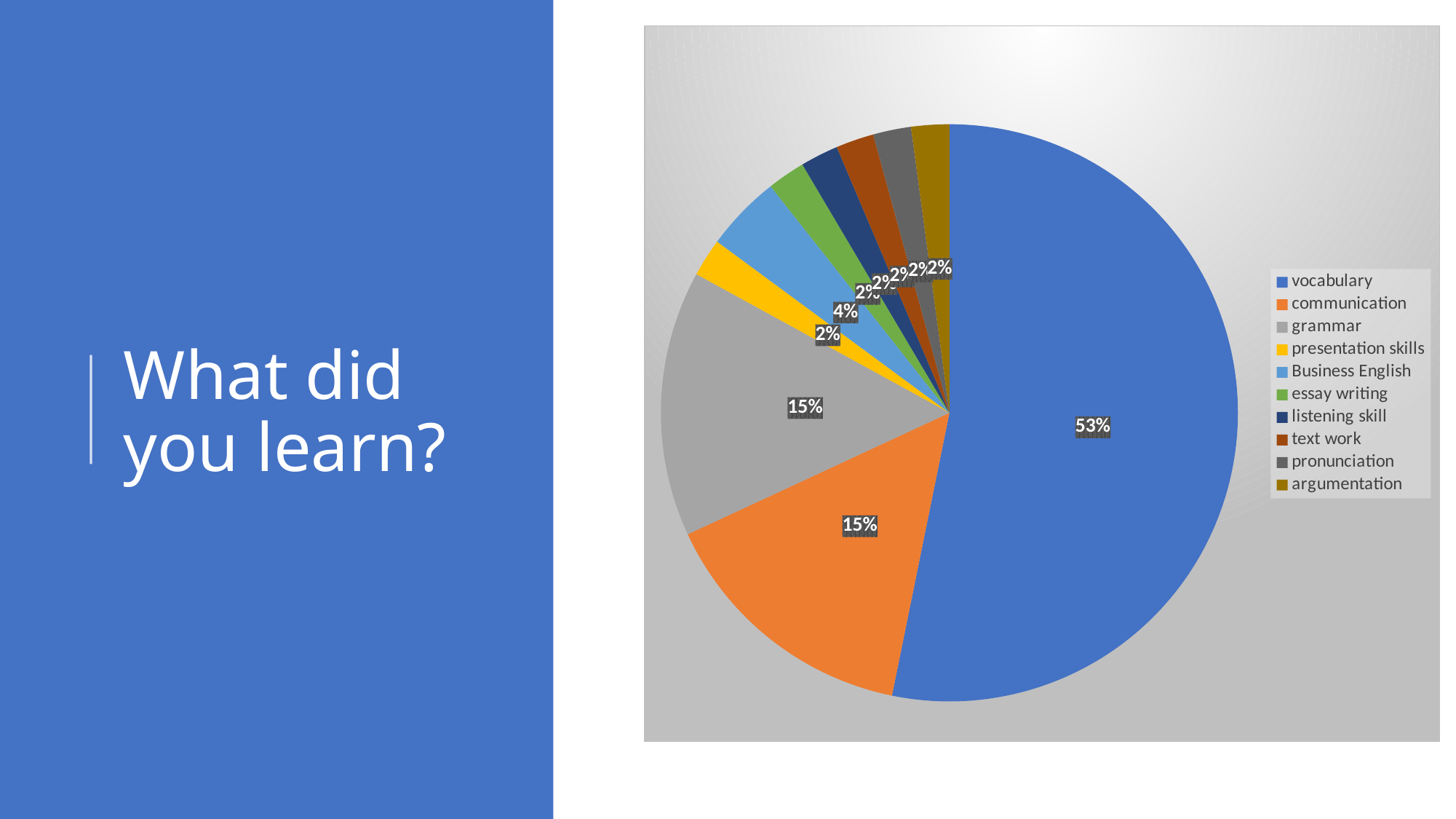
Which is larger, the share for Business English or the share for essay writing? Business English What percentage is shown for presentation skills? 2% What share of the pie does vocabulary have? 53% How many categories does the pie chart have? 10 Which is larger, the share for vocabulary or the share for grammar? vocabulary Which category has the largest share of the pie? vocabulary What percentage is shown for grammar? 15% What percentage is shown for communication? 15% What kind of chart is shown on the slide? pie chart What percentage is shown for Business English? 4% What is the difference in percentage points between vocabulary and communication? 38 What colour is the vocabulary slice in the pie chart? blue